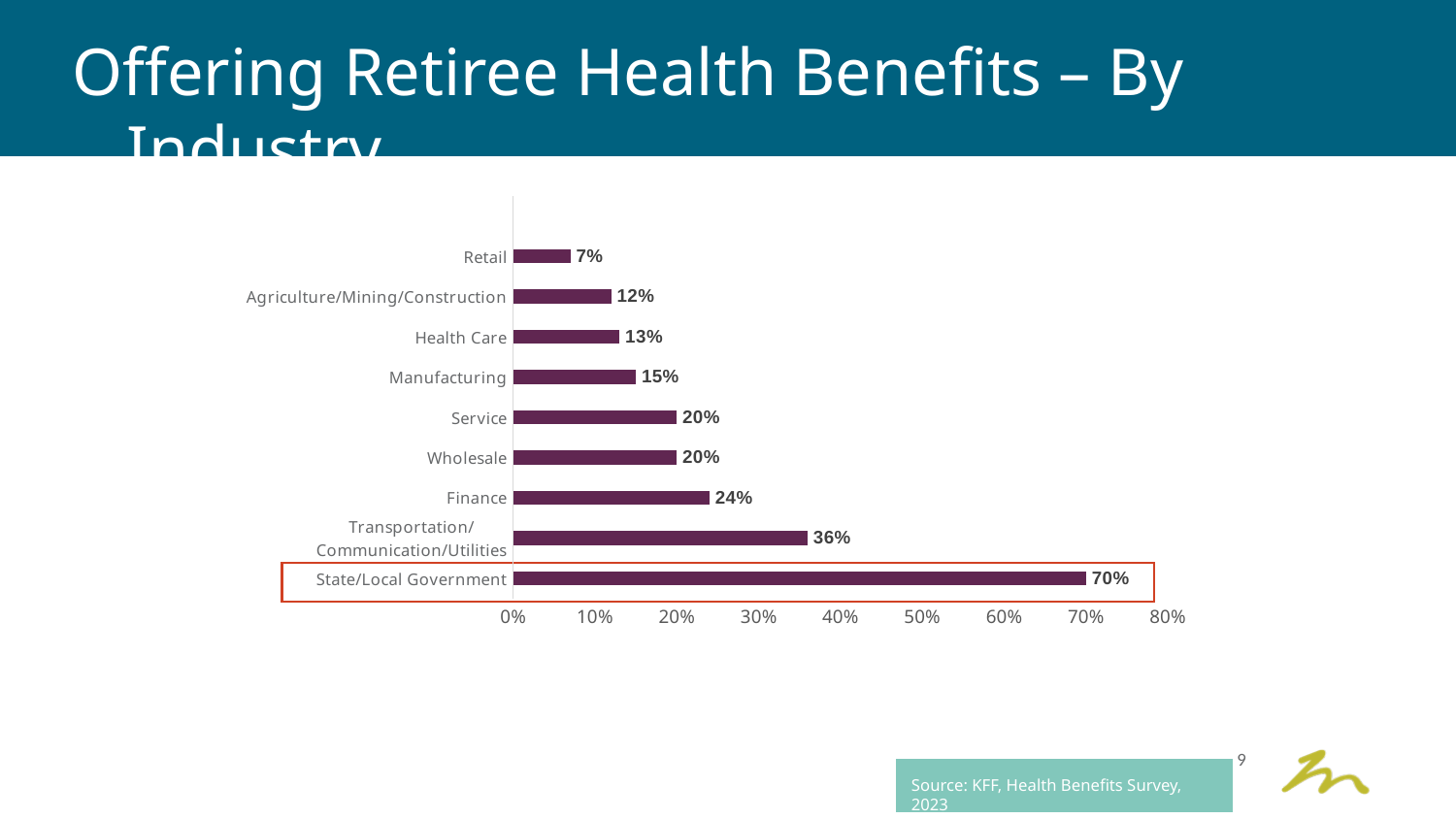
What kind of chart is shown on the slide? Bar chart Which is larger, the value for Manufacturing or the value for Finance? Finance Which industry has the lowest value? Retail What is the highest value shown on the x axis? 80% What is the difference between the values for Finance and Retail? 17% How many industries are shown in the chart? 9 What is the value for Transportation/Communication/Utilities? 36% What percentage is shown for Health Care? 13% Which industry has the highest value? State/Local Government What is the difference between the values for State/Local Government and Transportation/Communication/Utilities? 34% Which two industries share the same value of 20%? Service and Wholesale What percentage is shown for State/Local Government? 70%